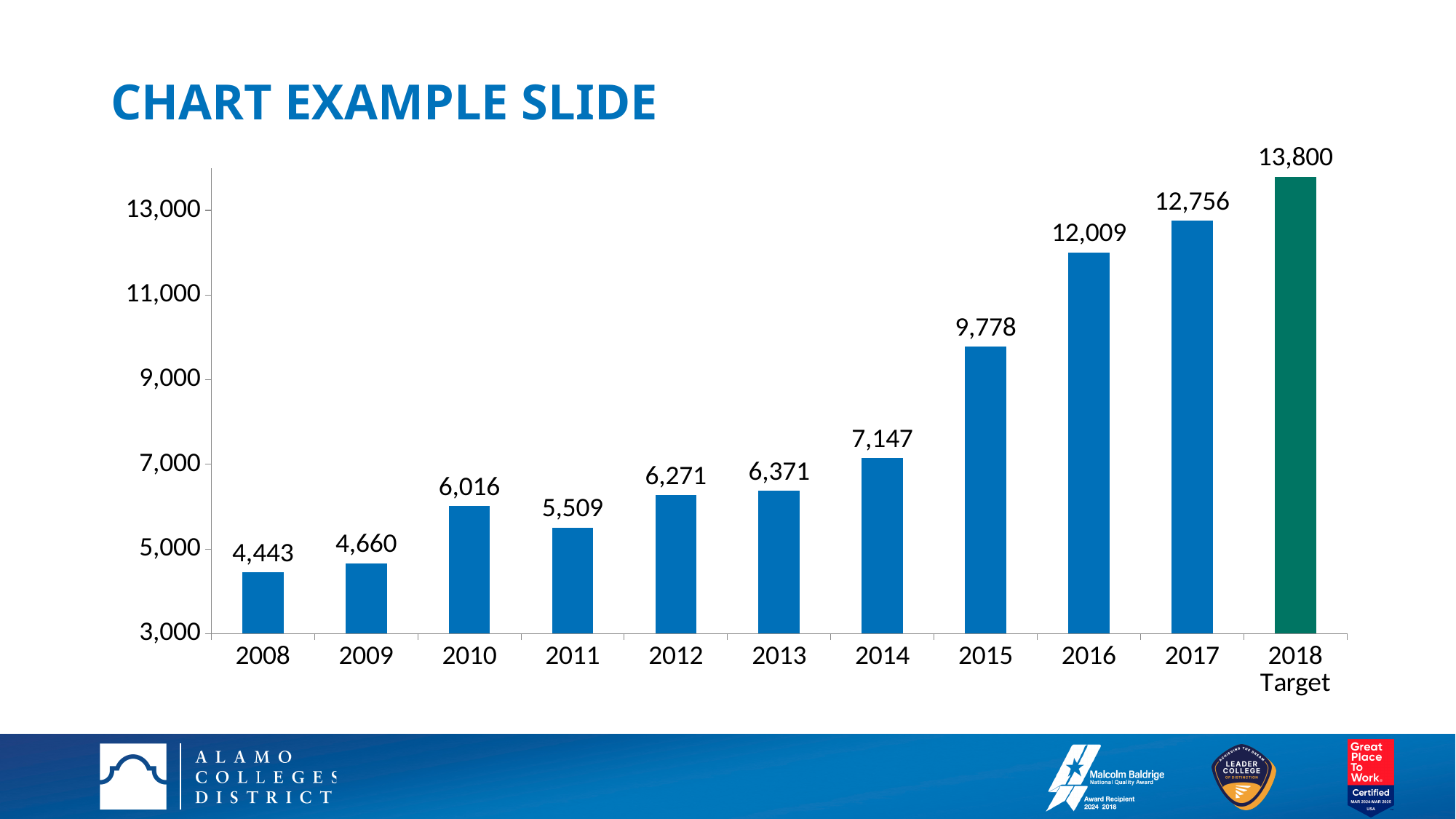
Is the value for 2015 greater or less than 9,000? greater How many bars are shown in the chart? 11 What is the value for 2010? 6,016 What is the difference between the 2018 Target and the 2017 value? 1,044 What is the value for 2016? 12,009 Which bar is shown in a different colour (green) from the others? 2018 Target Which category has the lowest value? 2008 What kind of chart is shown on the slide? Bar chart What is the difference between the values for 2017 and 2016? 747 Which category has the highest value? 2018 Target Which is larger, the value for 2010 or the value for 2011? 2010 What is the value shown for the 2018 Target bar? 13,800